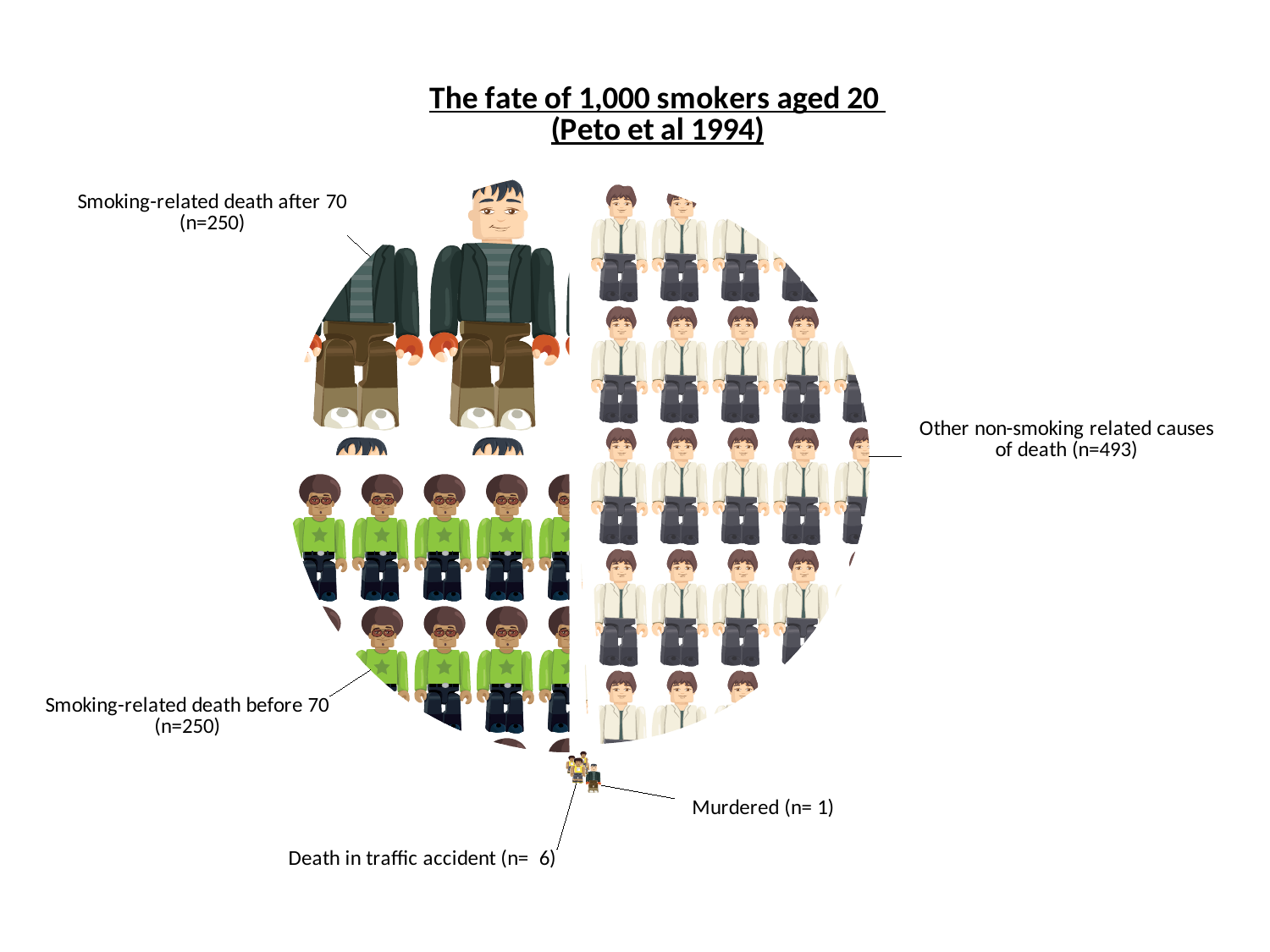
Which is larger: 'Death in traffic accident' or 'Murdered'? Death in traffic accident What is the value (n) for 'Other non-smoking related causes of death'? 493 What is the value (n) for 'Murdered'? 1 What share of the 1,000 smokers does 'Smoking-related death after 70' represent? 25% What is the value (n) for 'Smoking-related death before 70'? 250 What is the value (n) for 'Death in traffic accident'? 6 Which category has the largest share of the pie? Other non-smoking related causes of death How many categories does the pie chart show? 5 Which category has the smallest share of the pie? Murdered What kind of chart is shown on the slide? pie chart What is the difference between 'Other non-smoking related causes of death' and 'Smoking-related death after 70'? 243 What is the title of the chart? The fate of 1,000 smokers aged 20 (Peto et al 1994)